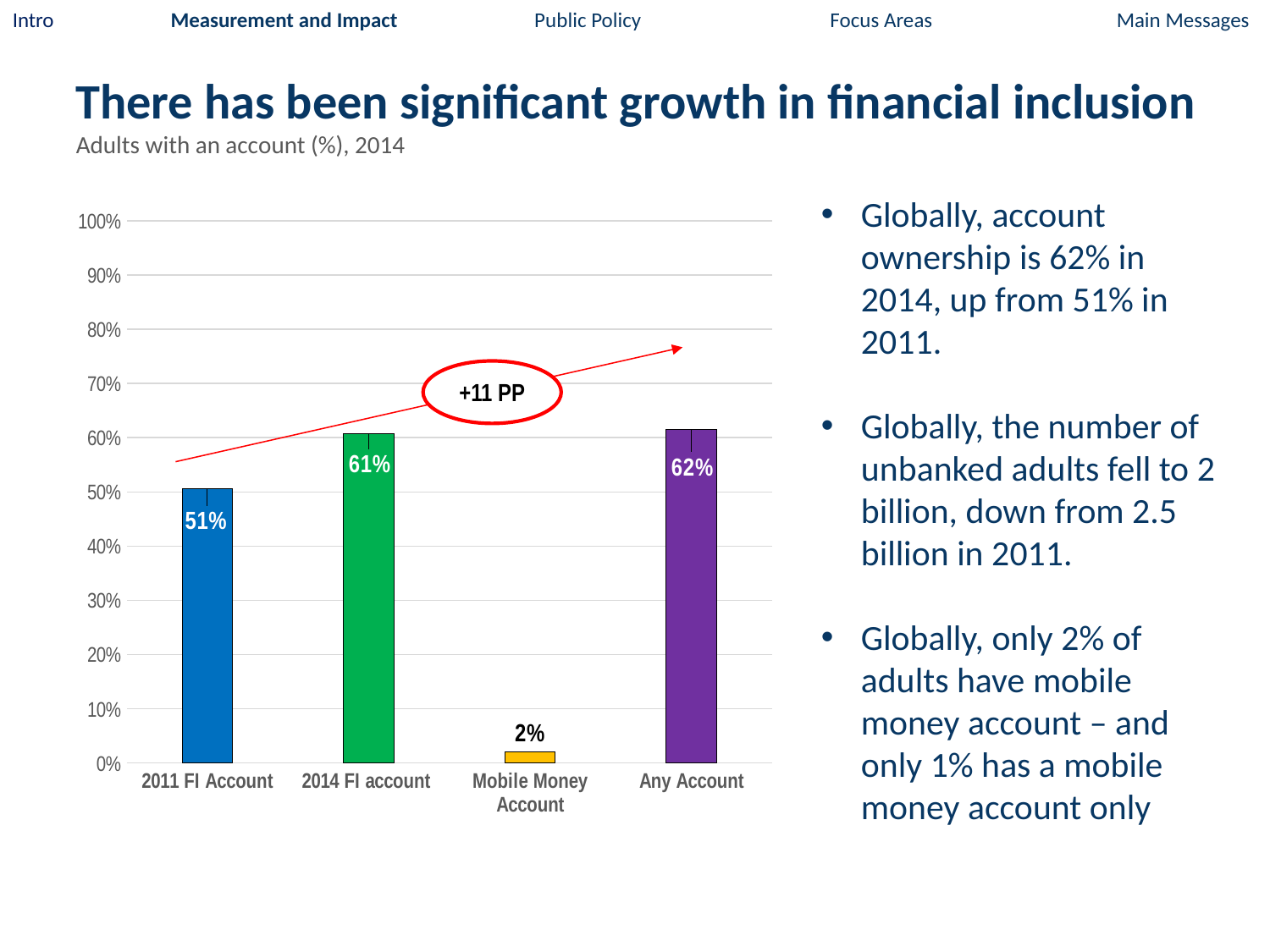
What is the difference between the Any Account value and the Mobile Money Account value? 60% Which category has the lowest value? Mobile Money Account What is the value for Any Account? 62% Which is larger, the value for 2011 FI Account or the value for 2014 FI account? 2014 FI account How many categories are shown on the x axis? 4 What is the value for Mobile Money Account? 2% What is the difference between the 2014 FI account value and the 2011 FI Account value? 10% What is the value for 2014 FI account? 61% What kind of chart is shown on the slide? bar chart What is the value for 2011 FI Account? 51% Is the value for Any Account greater or less than 50%? greater What label is shown in the red circle above the bars? +11 PP